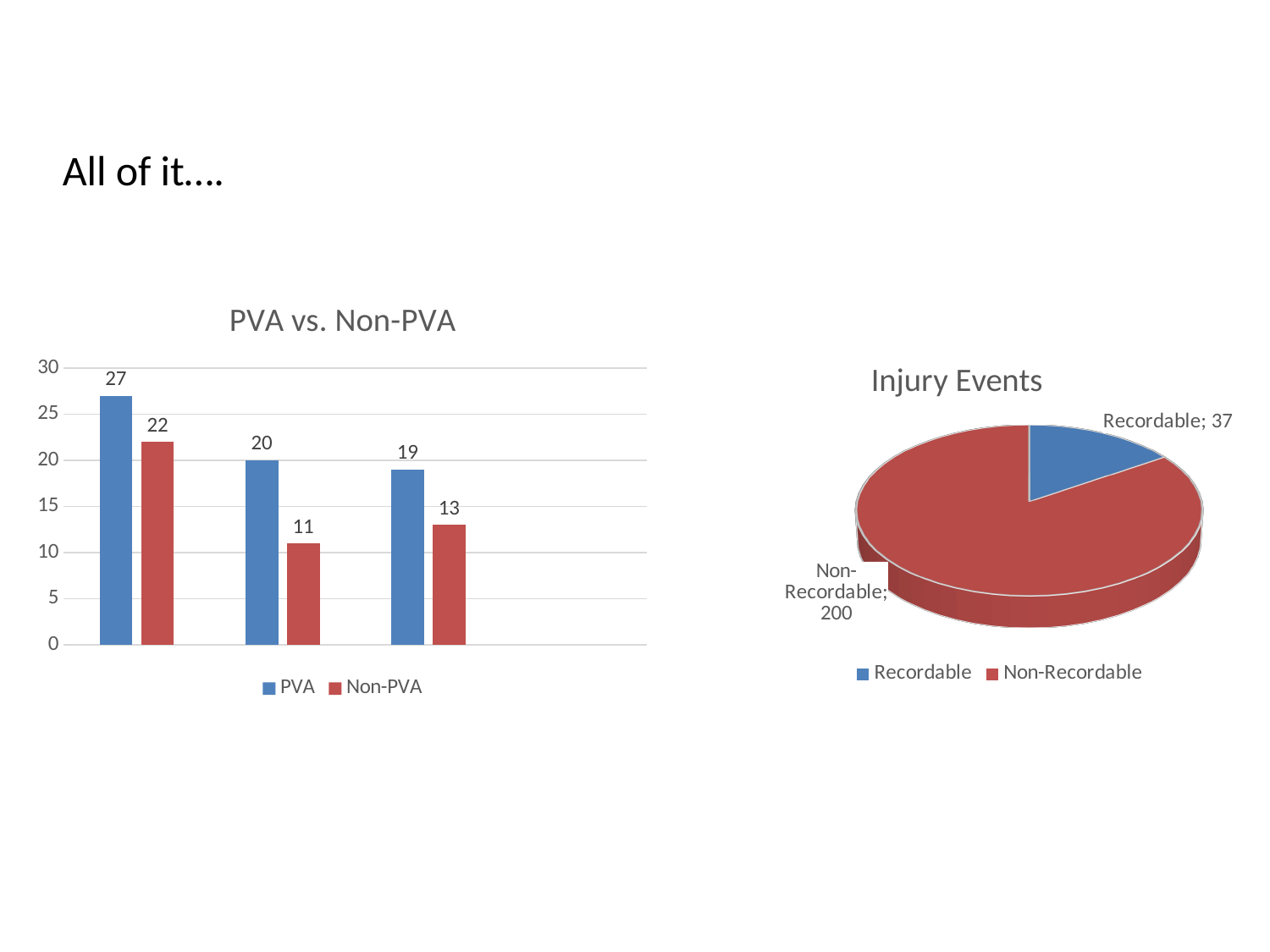
What kind of chart is the 'Injury Events' chart? pie chart In the 'PVA vs. Non-PVA' chart, what is the highest value shown for the PVA series? 27 In the 'PVA vs. Non-PVA' chart, what is the PVA value for the first group of bars? 27 In the 'PVA vs. Non-PVA' chart, what is the difference between the PVA and Non-PVA values in the second group of bars? 9 In the 'PVA vs. Non-PVA' chart, what is the Non-PVA value for the third group of bars? 13 In the 'PVA vs. Non-PVA' chart, what is the lowest value shown for the Non-PVA series? 11 In the 'PVA vs. Non-PVA' chart, which series has the larger value in the first group of bars, PVA or Non-PVA? PVA In the 'Injury Events' chart, what is the value for Non-Recordable? 200 In the 'PVA vs. Non-PVA' chart, what is the Non-PVA value for the second group of bars? 11 In the 'PVA vs. Non-PVA' chart, do the PVA values rise or fall from the first group to the third group? fall In the 'PVA vs. Non-PVA' chart, how many series does the legend list? 2 In the 'Injury Events' chart, what is the difference between the Non-Recordable and Recordable values? 163